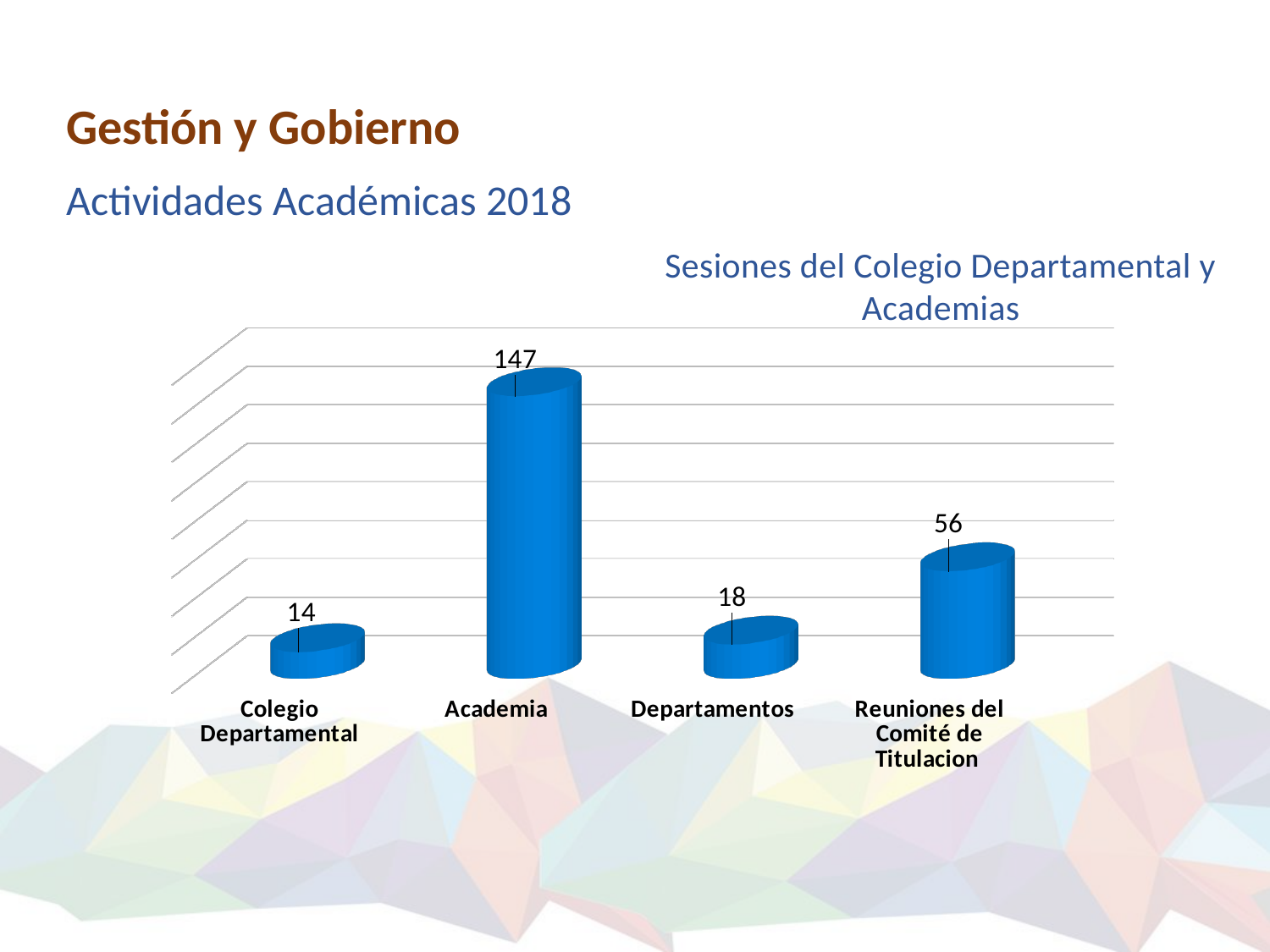
What is the value for Colegio Departamental? 14 What kind of chart is shown on the slide? Bar chart How many categories are shown in the chart? 4 Which category has the highest value? Academia What is the difference between the values for Academia and Reuniones del Comité de Titulacion? 91 What is the difference between the values for Departamentos and Colegio Departamental? 4 What is the value for Departamentos? 18 What is the value for Reuniones del Comité de Titulacion? 56 Which is larger, the value for Reuniones del Comité de Titulacion or the value for Departamentos? Reuniones del Comité de Titulacion What is the title of the chart? Sesiones del Colegio Departamental y Academias What is the value for Academia? 147 Which category has the lowest value? Colegio Departamental